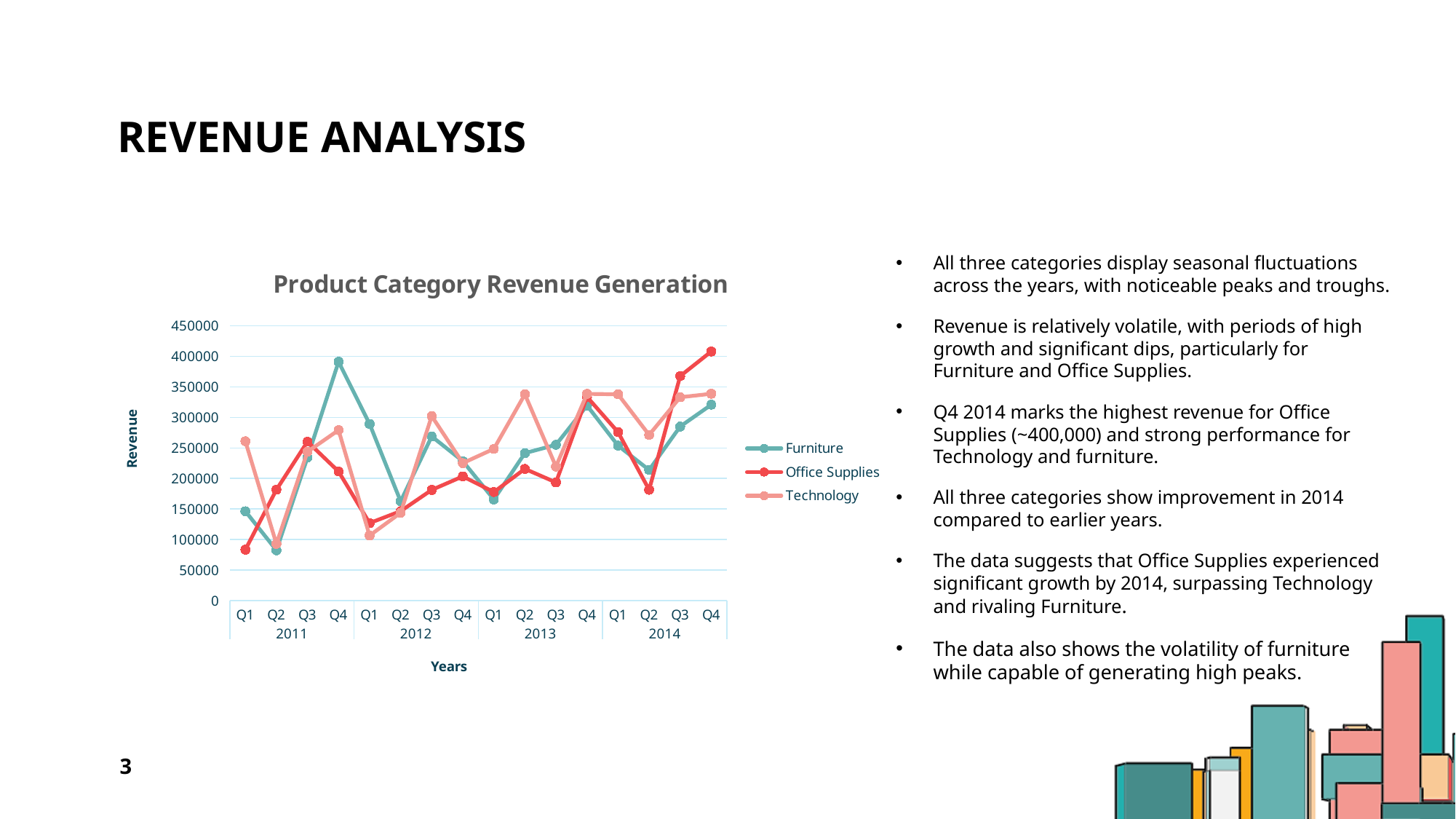
What kind of chart is shown on the slide? Line chart How many quarterly data points are plotted along the x axis for each series? 16 In which quarter does the Furniture series reach its highest value? Q4 2011 Is the Technology value for Q2 2013 greater or less than 300000? greater In which quarter does the Office Supplies series reach its highest value? Q4 2014 Is the Office Supplies value for Q1 2011 greater or less than 100000? less What is the title of the chart? Product Category Revenue Generation In Q4 2014, which is larger: Office Supplies or Furniture? Office Supplies Which series is drawn in the bright red line? Office Supplies Is the Furniture value for Q4 2011 greater or less than 350000? greater How many series does the legend list? 3